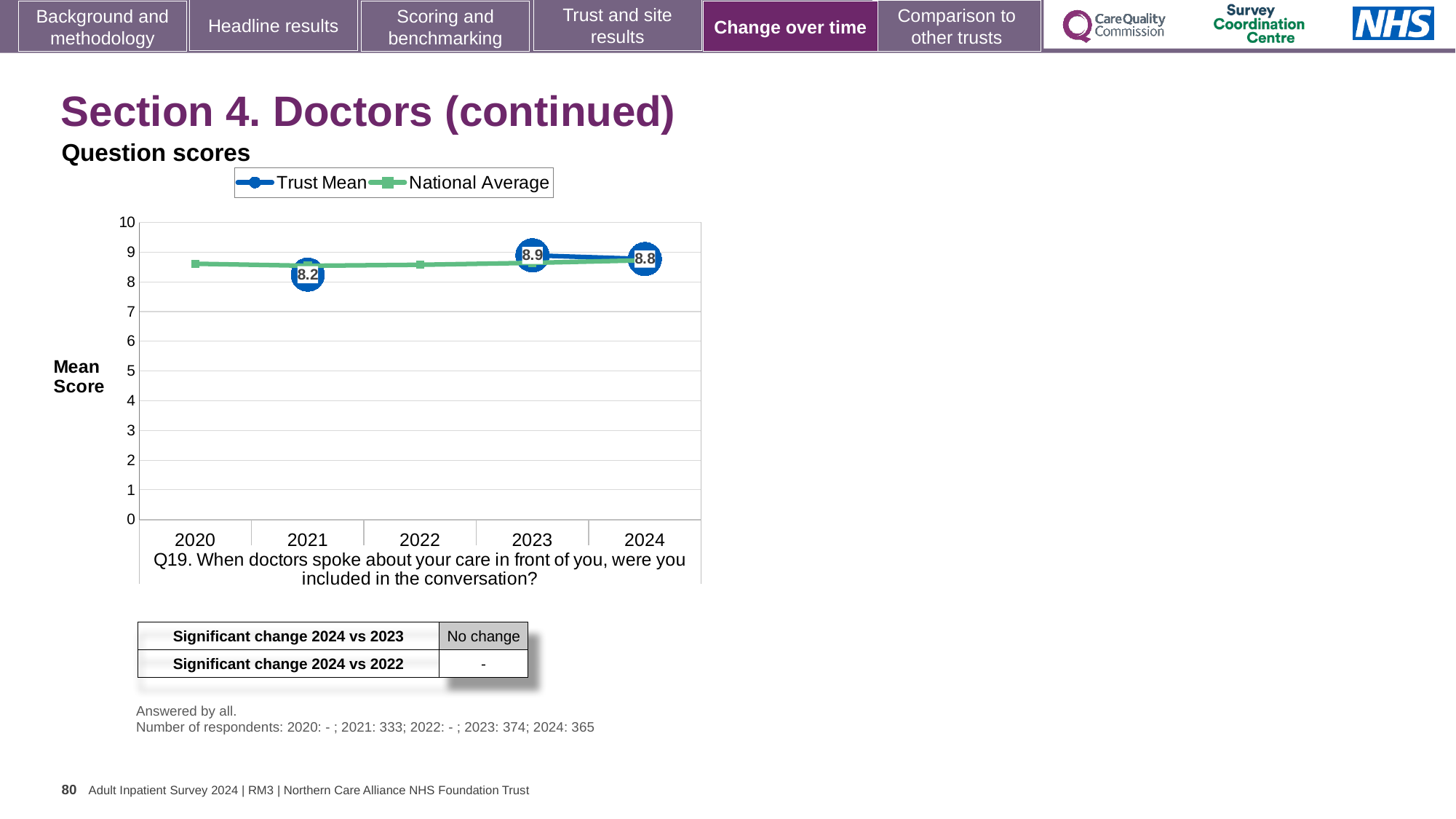
What is the Trust Mean value for 2021? 8.2 Which is larger, the Trust Mean for 2021 or for 2024? 2024 How many years are shown on the x axis? 5 In which year is the Trust Mean highest? 2023 What is the Trust Mean value for 2023? 8.9 What is the Trust Mean value for 2024? 8.8 How many series does the legend list? 2 What kind of chart is shown on the slide? line chart Is the National Average value for 2020 greater or less than 8? greater In which year is the Trust Mean lowest among the labelled years? 2021 Does the Trust Mean rise or fall from 2021 to 2023? rise What is the difference between the Trust Mean in 2023 and in 2021? 0.7